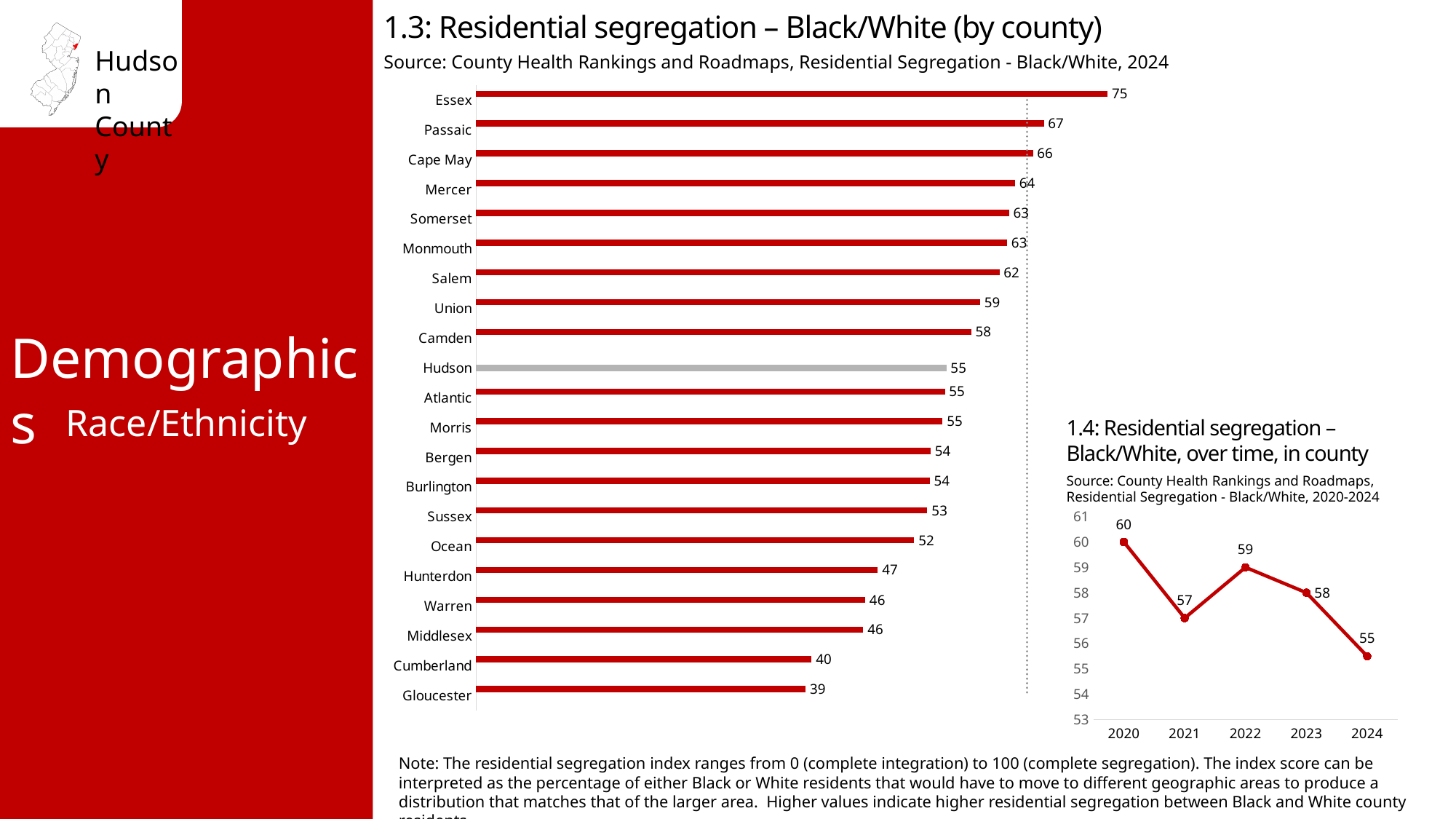
In chart 1.3 (by county), which county has the highest residential segregation index? Essex In chart 1.4 (over time in county), what is the difference between the 2020 and 2024 values? 5 In chart 1.3 (Residential segregation – Black/White by county), what is the value for Hudson? 55 In chart 1.4 (over time in county), how many years are plotted? 5 In chart 1.4 (Residential segregation over time in county), what is the value for 2022? 59 In chart 1.3 (by county), how many counties are shown? 21 What kind of chart is chart 1.3 (Residential segregation – Black/White by county)? Bar chart In chart 1.3 (by county), what is the value for Cumberland? 40 In chart 1.3 (by county), what is the difference between the values for Essex and Hudson? 20 In chart 1.3 (by county), which has a larger value, Passaic or Mercer? Passaic In chart 1.4 (over time in county), which year has the lowest value? 2024 In chart 1.3 (by county), which county has the lowest residential segregation index? Gloucester